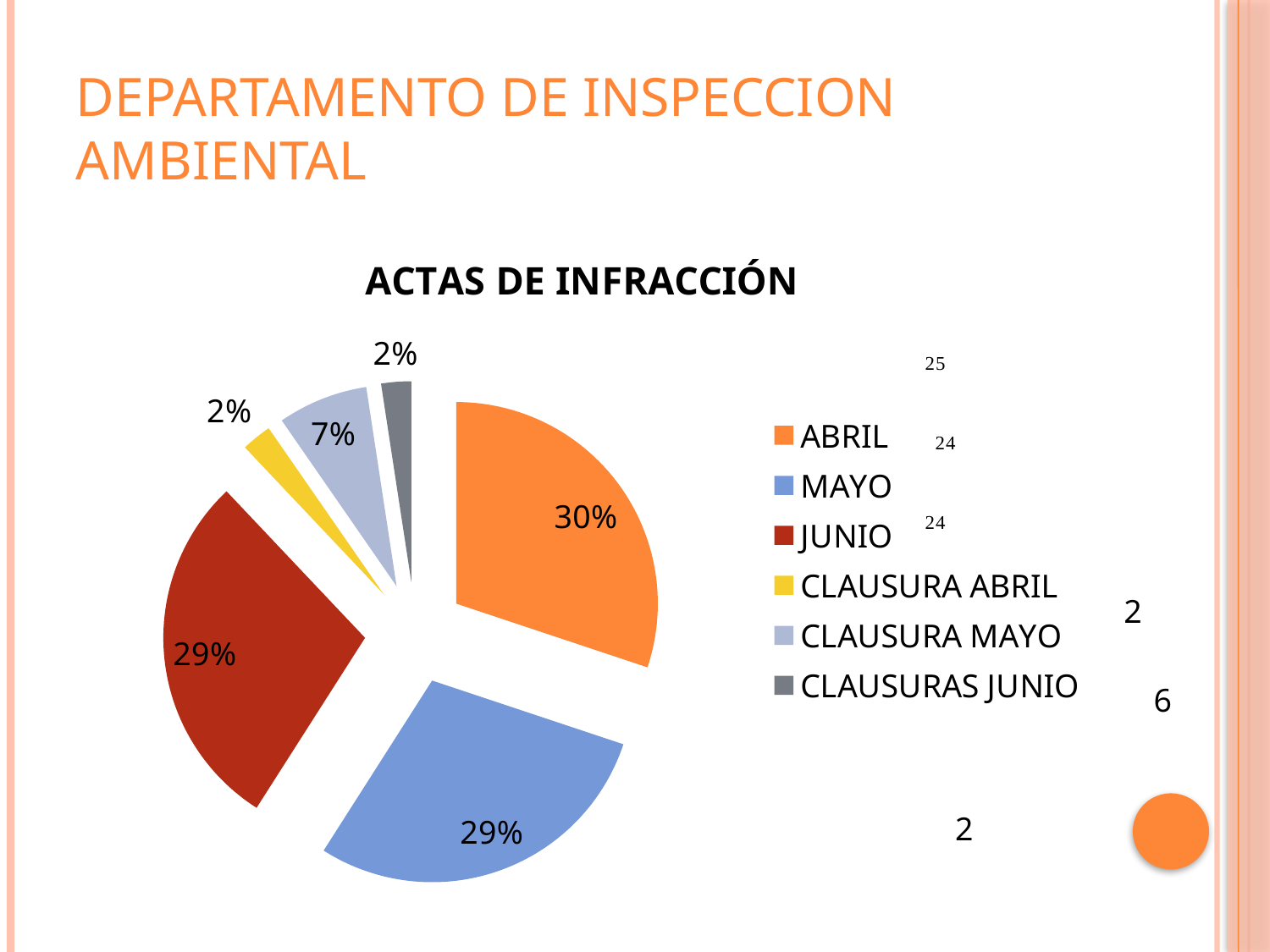
What share of the pie does ABRIL represent? 30% Which is larger, the slice for CLAUSURA MAYO or the slice for CLAUSURA ABRIL? CLAUSURA MAYO How many percentage points larger is the ABRIL slice than the CLAUSURA MAYO slice? 23 percentage points What is the title of the chart? ACTAS DE INFRACCIÓN What share of the pie does CLAUSURA MAYO represent? 7% How many categories are shown in the pie chart? 6 What colour is the ABRIL slice in the pie chart? Orange What type of chart is shown on the slide? Pie chart Which category has the largest slice of the pie? ABRIL What share of the pie does CLAUSURA ABRIL represent? 2%